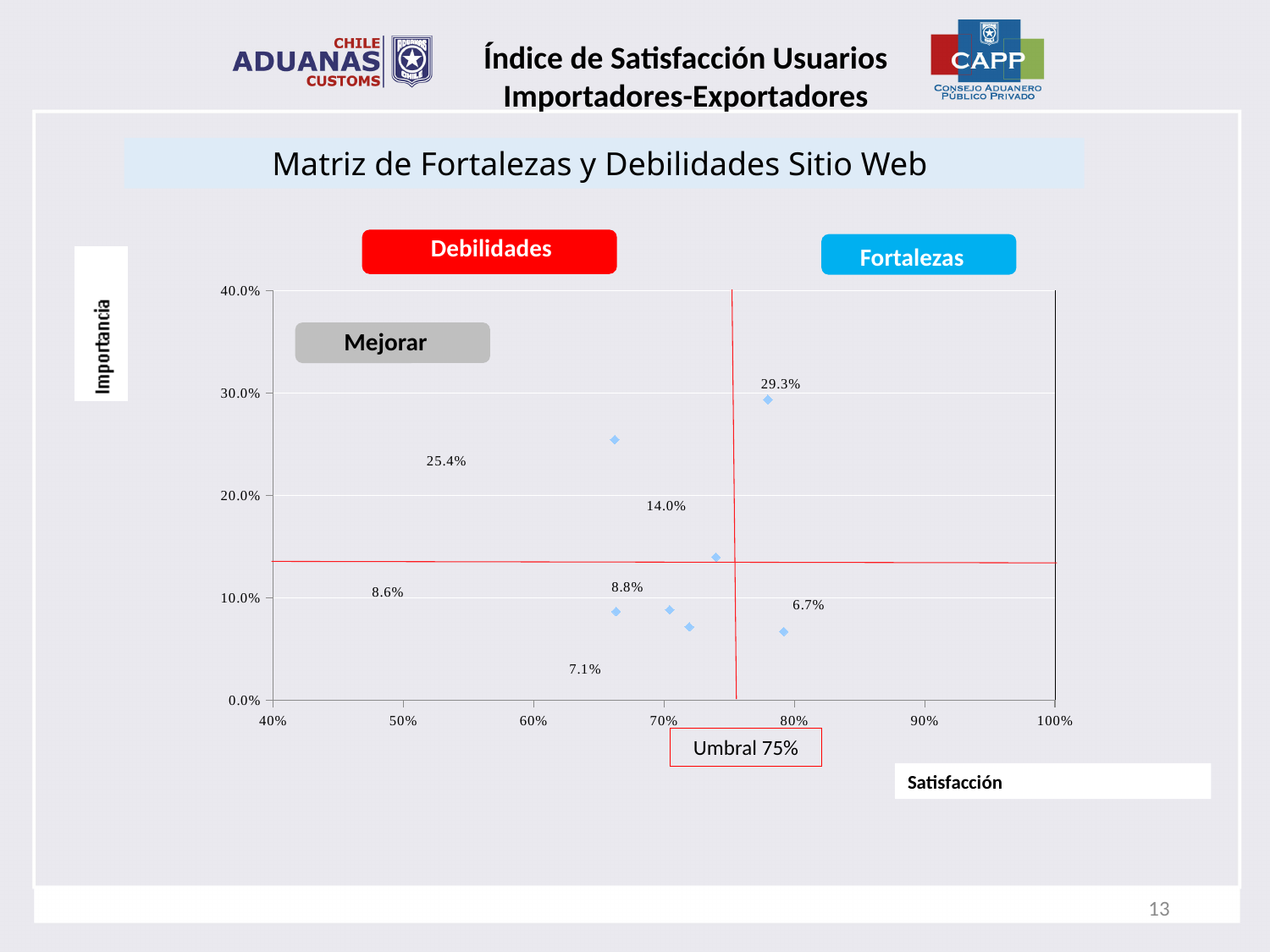
How many data points are plotted on the chart? 7 What is the highest importance value labeled on the chart? 29.3% Which is larger, the point labeled 14.0% or the point labeled 8.8%? 14.0% Is the satisfaction value of the point labeled 25.4% greater or less than 70%? less Is the satisfaction value of the point labeled 29.3% greater or less than 75%? greater What is the maximum value shown on the vertical axis? 40.0% What is the label of the vertical axis of the chart? Importancia What is the difference between the two highest labeled importance values, 29.3% and 25.4%? 3.9% What threshold (Umbral) value is marked by the vertical line on the chart? 75% How many data points lie to the right of the 75% threshold line (in the Fortalezas area)? 2 What is the lowest importance value labeled on the chart? 6.7% What kind of chart is shown on the slide? scatter chart